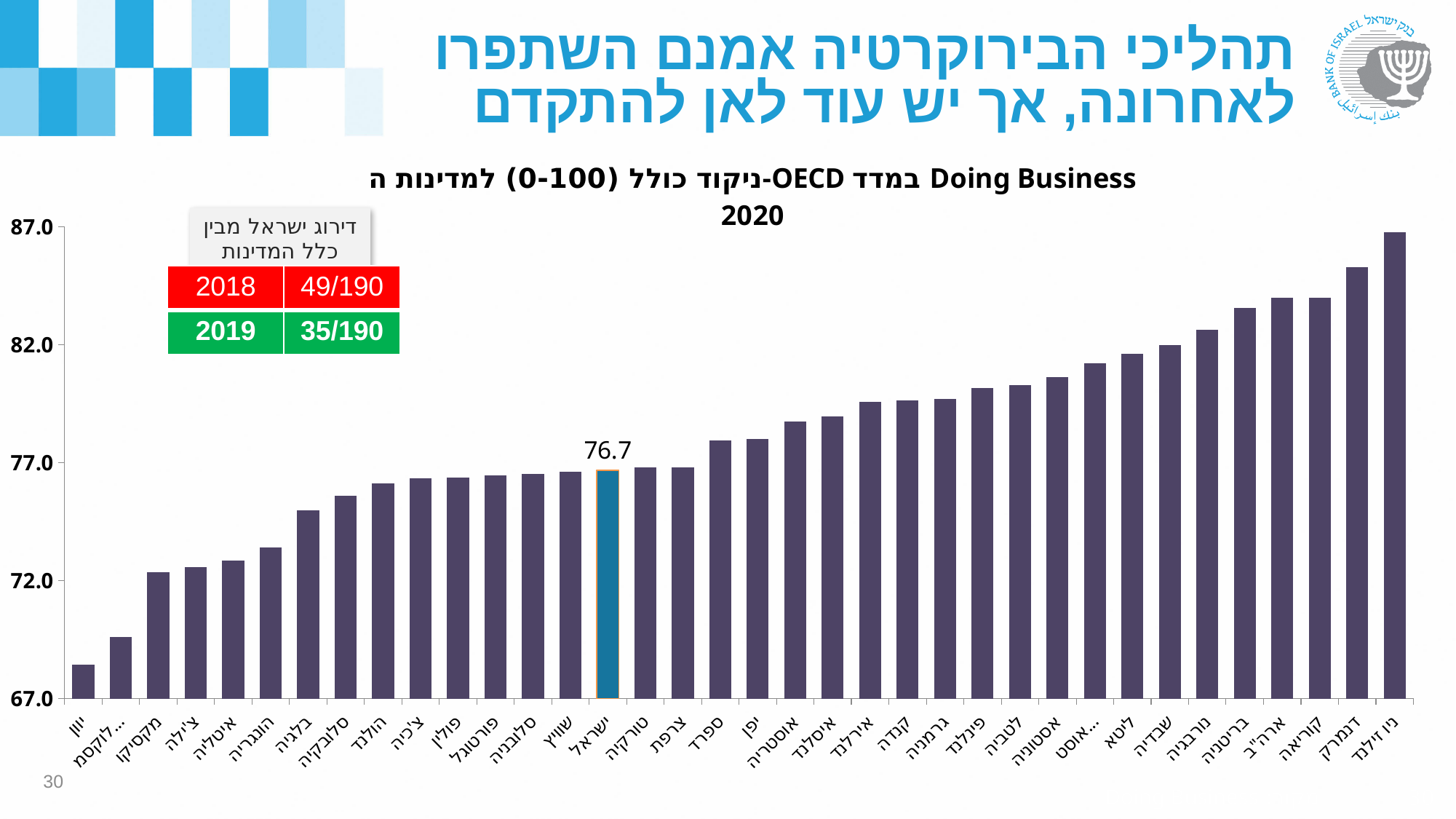
Which country has the lowest score in the chart? יוון Is the value for ניו זילנד greater or less than 82.0? greater Which has a higher score, יוון or דנמרק? דנמרק Which has a higher score, ספרד or ישראל? ספרד Which country's bar is highlighted in a different colour (blue) from the others? ישראל What is the Doing Business 2020 score shown for ישראל (Israel)? 76.7 Is the value for דנמרק greater or less than 82.0? greater Which country has the highest score in the chart? ניו זילנד Do the values rise or fall moving from left to right along the x axis? rise Is the value for יפן greater or less than 77.0? greater What kind of chart is shown on the slide? bar chart